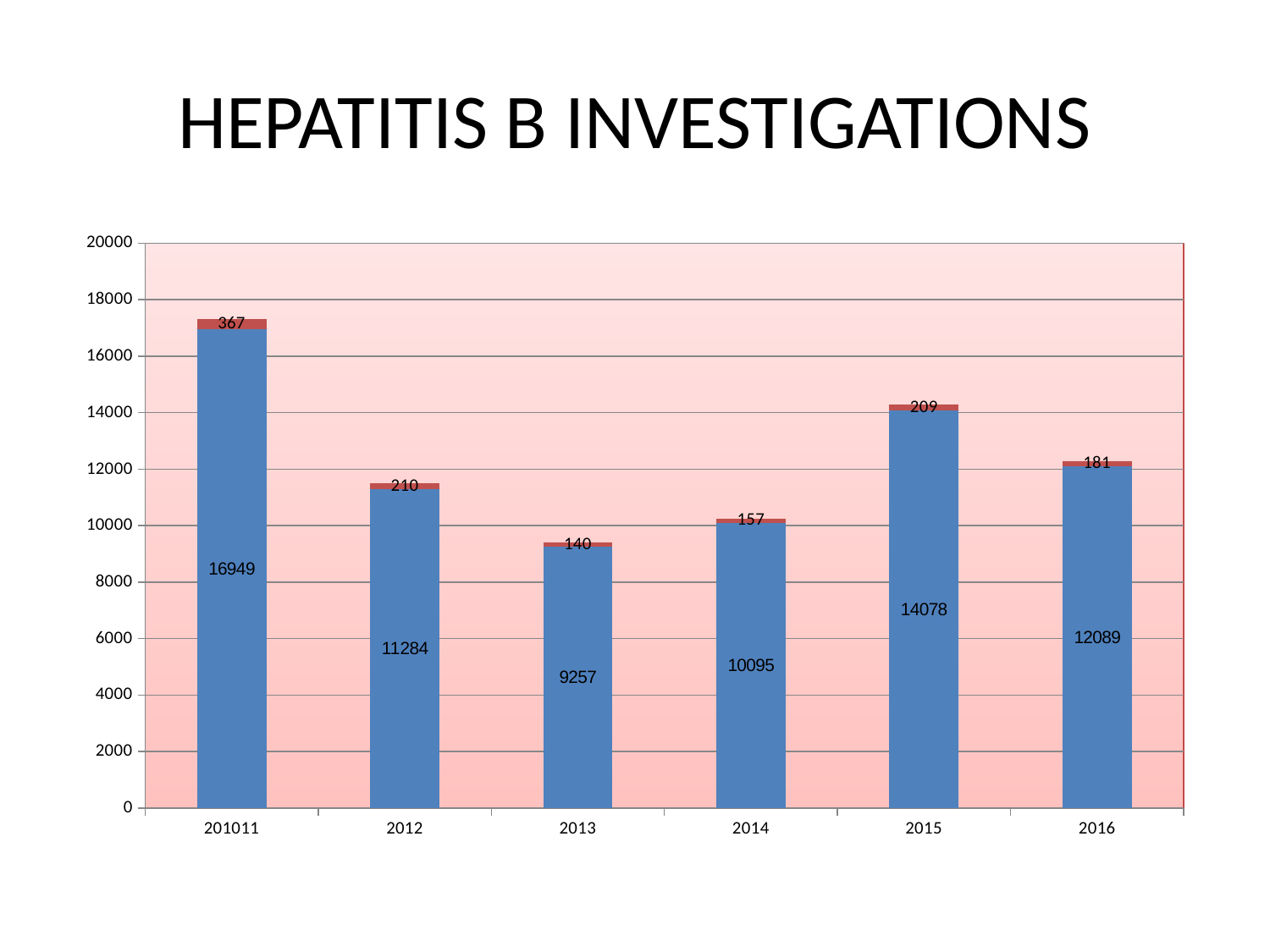
What is the value of the red segment for 2013? 140 Do the blue segment values rise or fall from 2013 to 2015? Rise What kind of chart is shown on the slide? Stacked bar chart What is the value of the blue segment for 2015? 14078 How many categories are shown on the x axis? 6 What is the difference between the blue segment values for 2015 and 2016? 1989 Which category has the lowest red segment value? 2013 Which category has the highest blue segment value? 201011 What is the value of the blue segment for 201011? 16949 What is the total of the stacked bar for 2014? 10252 Which is larger, the red segment for 2012 or the red segment for 2015? 2012 What is the title of the chart? HEPATITIS B INVESTIGATIONS